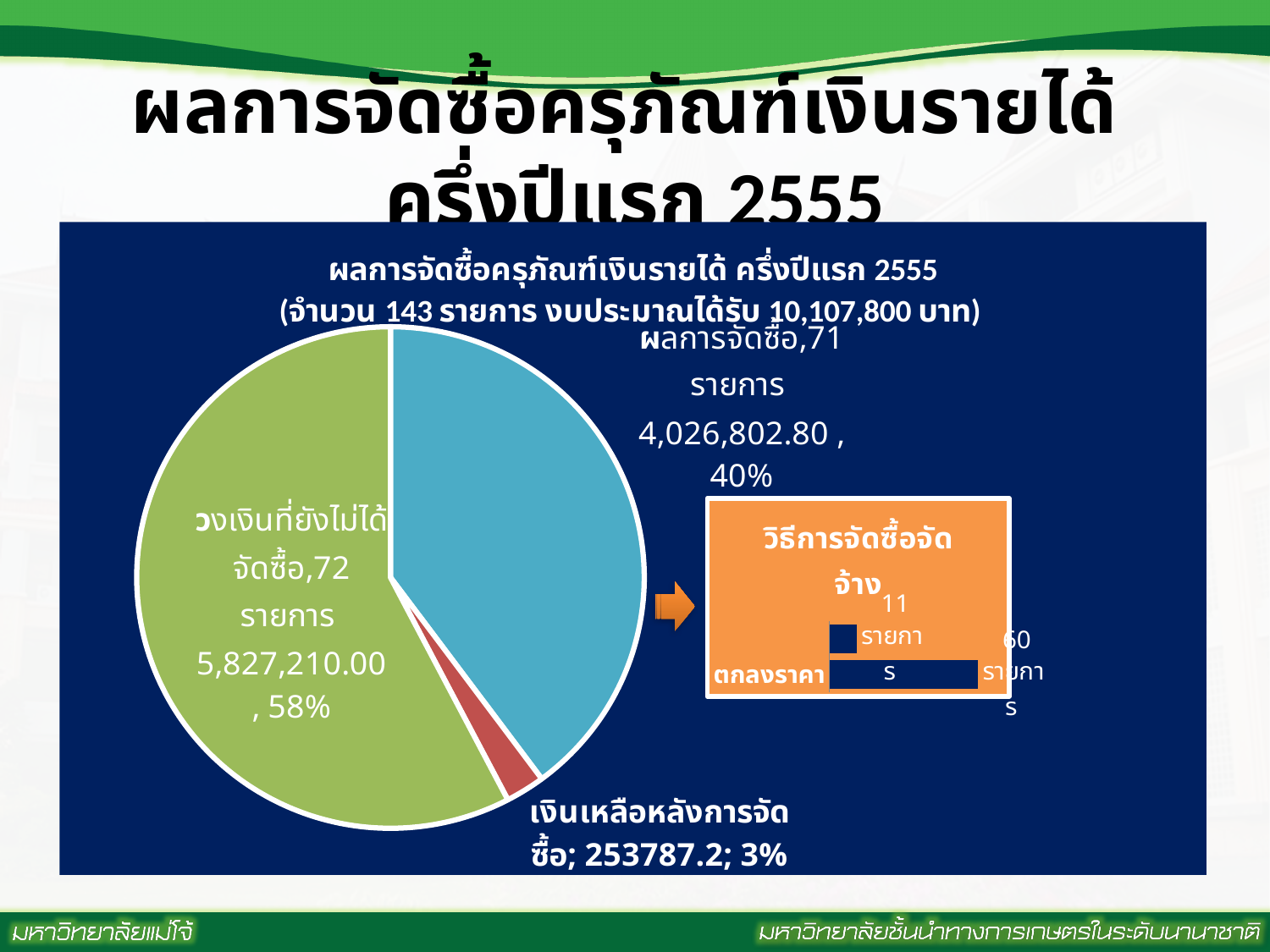
What is the amount shown for วงเงินที่ยังไม่ได้จัดซื้อ in the pie chart? 5,827,210.00 What kind of chart is the main chart on the slide? pie chart According to the chart title, what total budget (งบประมาณได้รับ) was received? 10,107,800 บาท Which slice of the pie chart is the smallest? เงินเหลือหลังการจัดซื้อ Which slice of the pie chart is the largest? วงเงินที่ยังไม่ได้จัดซื้อ What share of the pie does the เงินเหลือหลังการจัดซื้อ slice represent? 3% What is the amount shown for เงินเหลือหลังการจัดซื้อ in the pie chart? 253787.2 How many slices does the pie chart have? 3 What share of the pie does the ผลการจัดซื้อ slice represent? 40% How many รายการ are shown for ผลการจัดซื้อ in the pie chart label? 71 รายการ What is the amount shown for ผลการจัดซื้อ in the pie chart? 4,026,802.80 What share of the pie does the วงเงินที่ยังไม่ได้จัดซื้อ slice represent? 58%